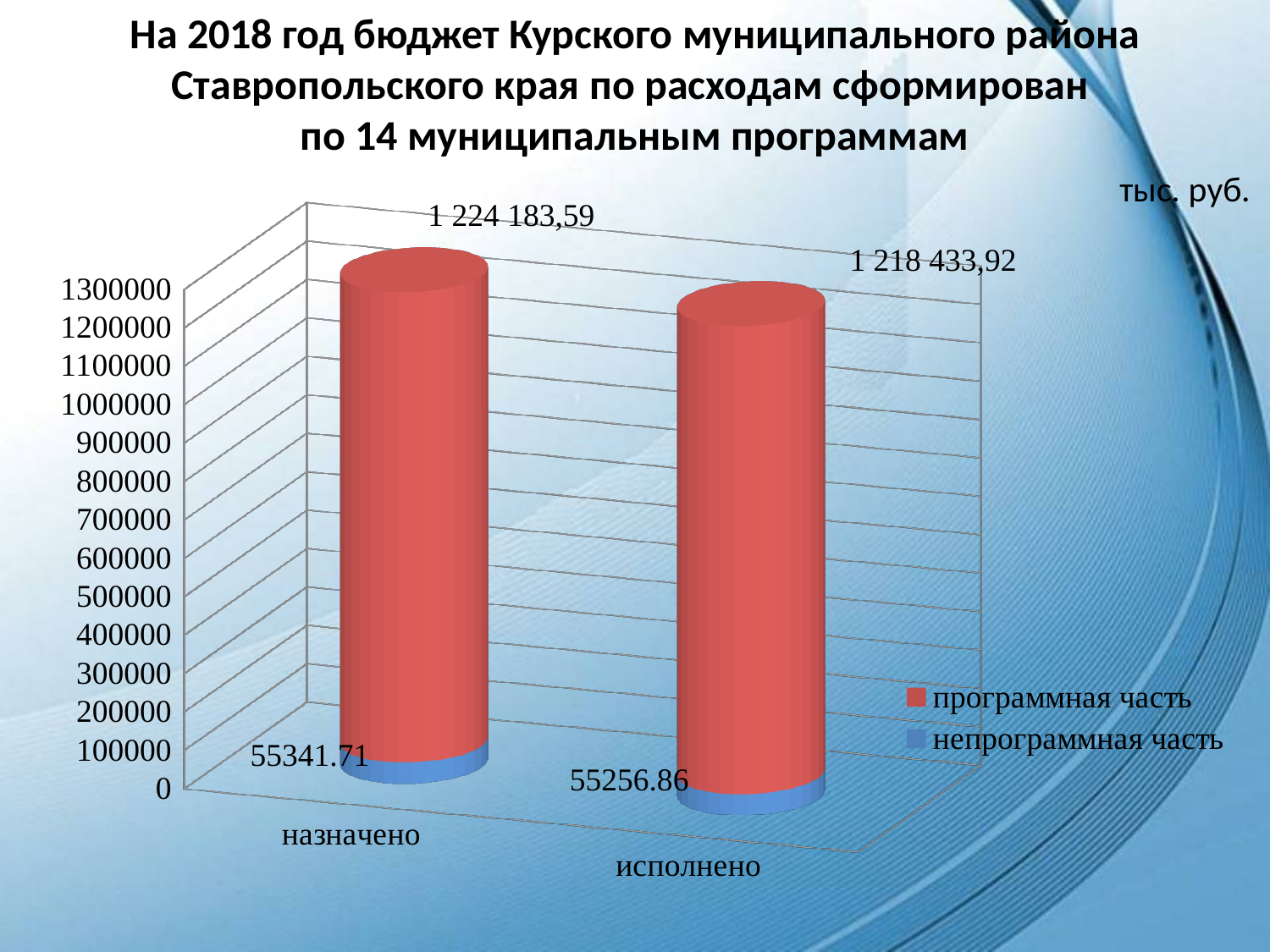
What kind of chart is shown on the slide? Stacked bar chart How many series does the chart legend list? 2 What value is shown for the программная часть series in the исполнено category? 1 218 433,92 What value is shown for the непрограммная часть series in the назначено category? 55341.71 How many categories are shown on the x axis of the chart? 2 Which category has the lower value for the непрограммная часть series? исполнено What unit is indicated for the values in the chart? тыс. руб. What value is shown for the программная часть series in the назначено category? 1 224 183,59 What is the difference between the непрограммная часть values for назначено and исполнено? 84.85 What is the difference between the программная часть values for назначено and исполнено? 5 749,67 What value is shown for the непрограммная часть series in the исполнено category? 55256.86 Which category has the higher value for the программная часть series? назначено